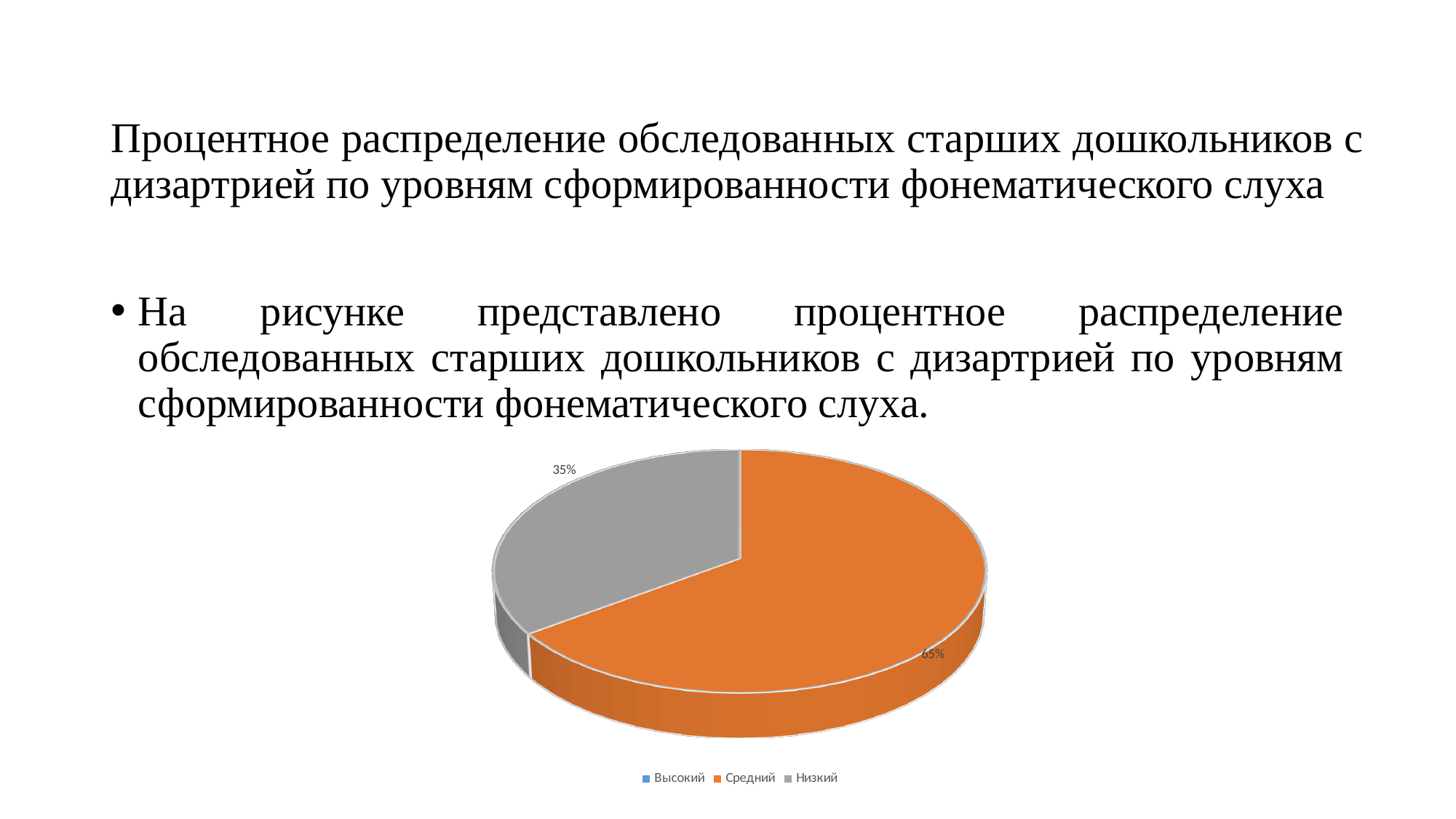
What kind of chart is shown on the slide? pie chart What percentage of the pie is the Средний slice? 65% How many entries does the legend list? 3 Which is larger, the Средний slice or the Низкий slice? Средний Which level has the largest slice of the pie? Средний Is the Средний slice greater or less than 50% of the pie? greater What colour is the Средний slice? orange What is the difference in percentage points between the Средний and Низкий slices? 30 What percentage of the pie is the Низкий slice? 35% What colour is the Низкий slice? grey Is the Низкий slice greater or less than 50% of the pie? less